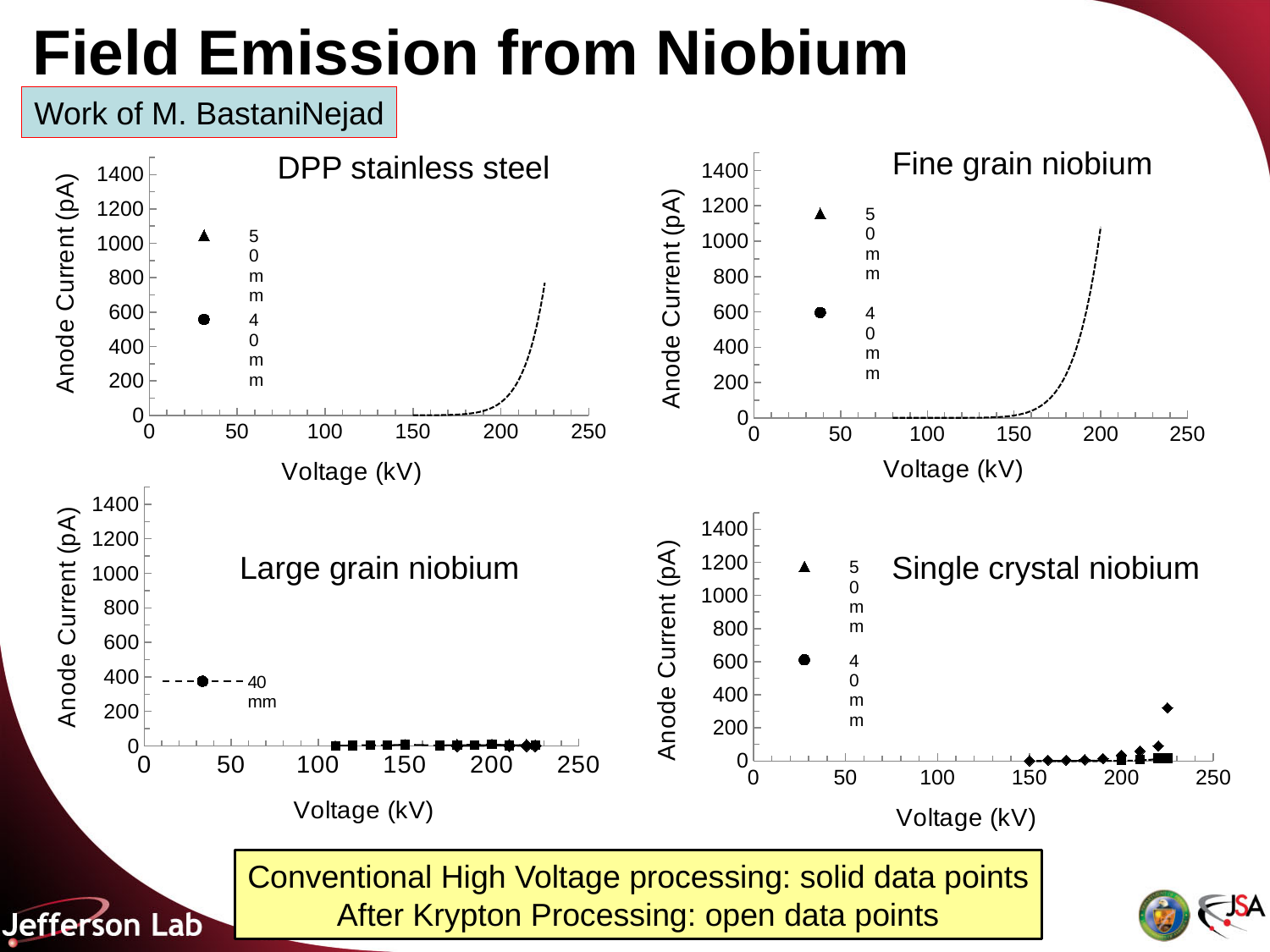
In the DPP stainless steel chart, does the anode current rise or fall as the voltage increases above 150 kV? rise What is the title of the chart in the bottom-right position? Single crystal niobium In the Large grain niobium chart, what is the highest value shown on the y axis? 1400 How many charts are shown on the slide? 4 In the Large grain niobium chart, how many entries does the legend list? 1 In the DPP stainless steel chart, is the anode current at the highest plotted voltage (about 225 kV) greater or less than 600 pA? greater In the Fine grain niobium chart, is the anode current at the highest plotted voltage (about 200 kV) greater or less than 800 pA? greater In the Fine grain niobium chart, what is the label of the x axis? Voltage (kV) In the Single crystal niobium chart, is the highest plotted anode current greater or less than 400 pA? less In the Fine grain niobium chart, how many entries does the legend list? 2